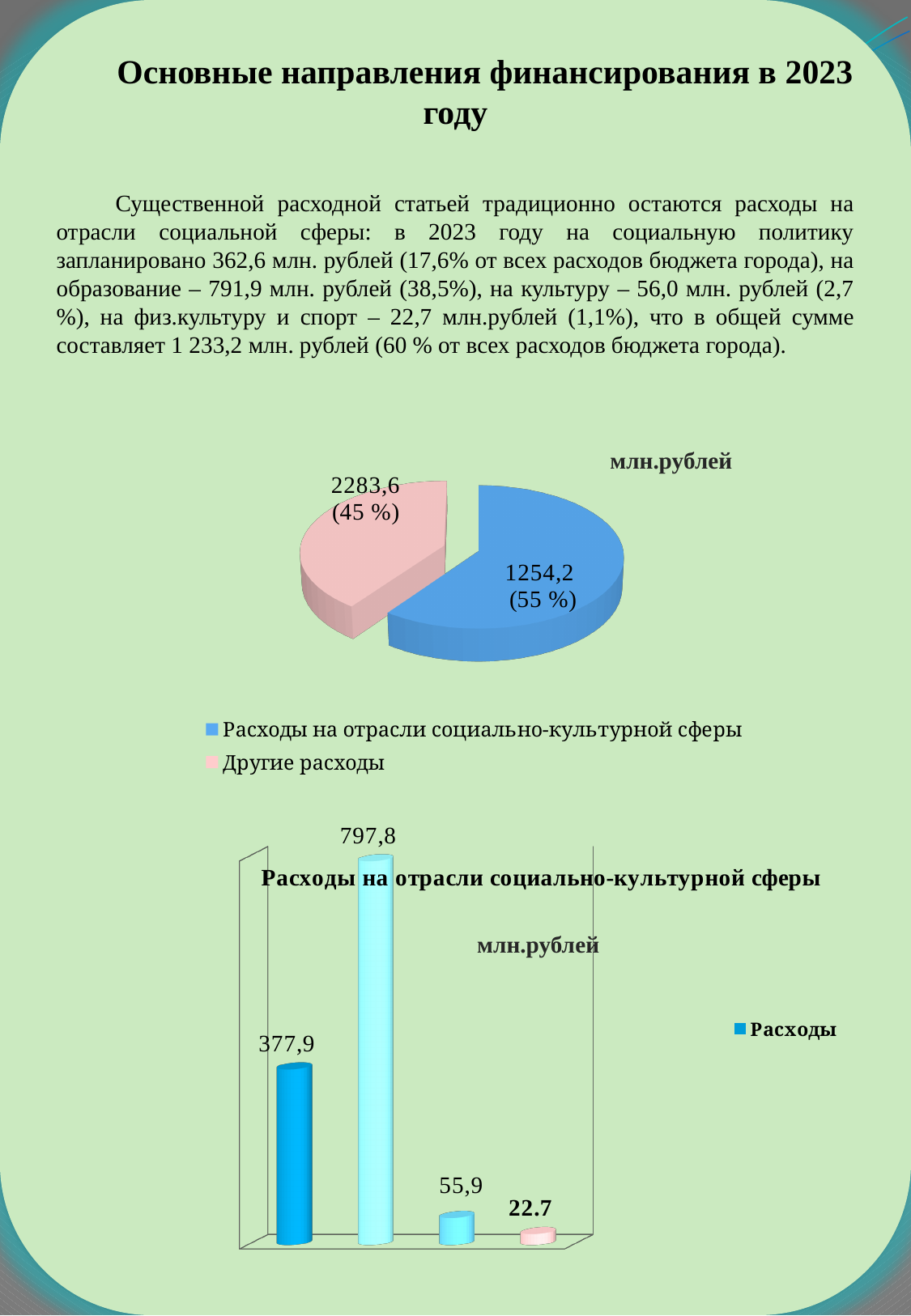
How many entries does the legend of the pie chart list? 2 In the bottom bar chart, how many bars are plotted? 4 In the pie chart, what value is shown for the slice 'Расходы на отрасли социально-культурной сферы'? 1254,2 In the bottom bar chart, what series name does the legend show? Расходы In the pie chart, what percentage is printed on the 'Другие расходы' slice? 45 % In the pie chart, what percentage is printed on the 'Расходы на отрасли социально-культурной сферы' slice? 55 % In the bottom bar chart, what is the value of the smallest bar? 22.7 What type of chart is the top chart on the slide? Pie chart In the bottom bar chart, what is the value of the tallest bar? 797,8 In the pie chart, what value is shown for the slice 'Другие расходы'? 2283,6 In the bottom bar chart, what is the difference between the second bar (797,8) and the first bar (377,9)? 419,9 What type of chart is the bottom chart titled 'Расходы на отрасли социально-культурной сферы'? Bar chart